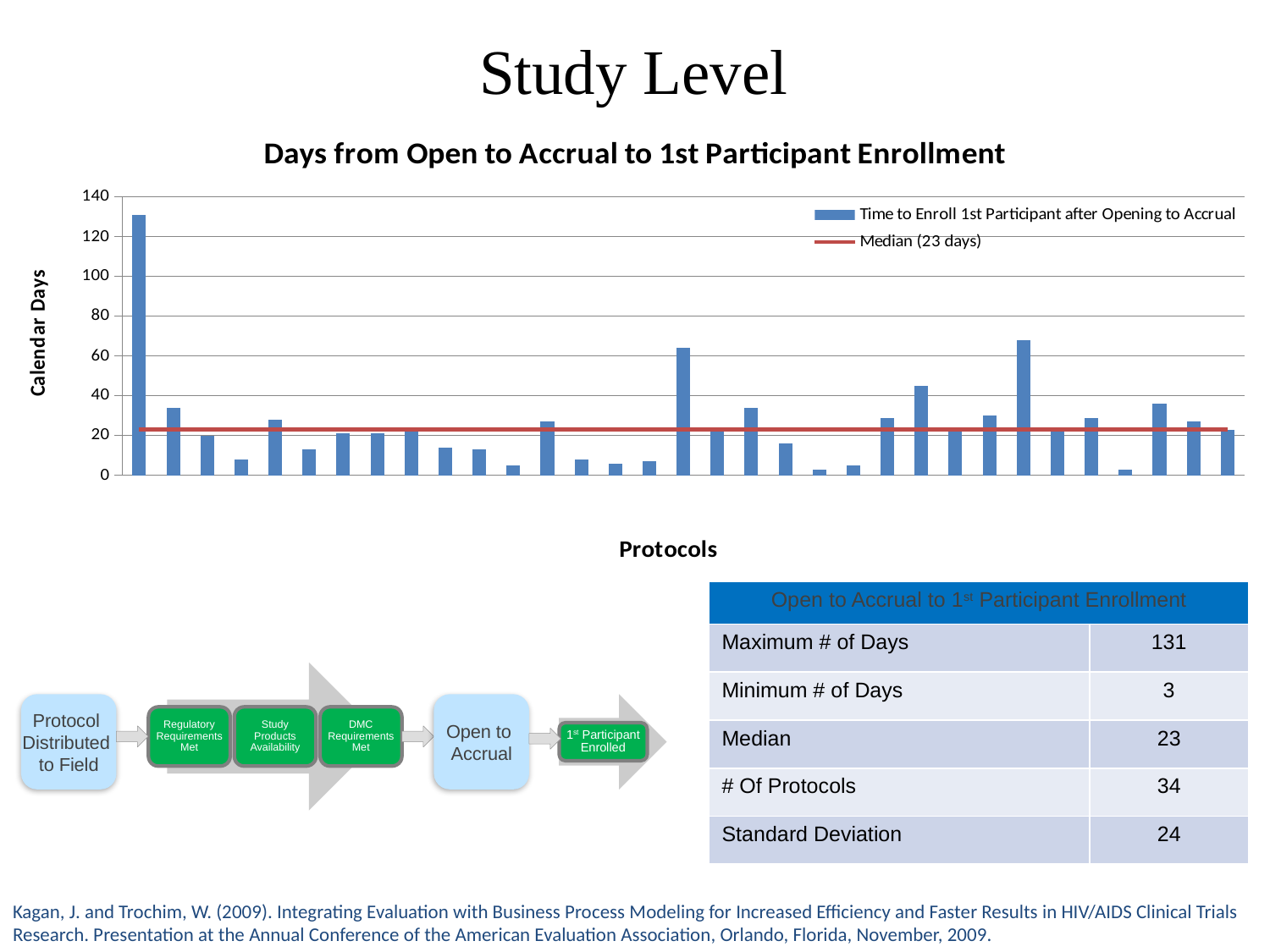
Which bar in the chart is the tallest: the leftmost bar or the rightmost bar? the leftmost bar What is the minimum number of days from open to accrual to 1st participant enrollment shown on the slide? 3 Is the value for the fourth bar from the left greater or less than 20? less What kind of chart is shown on the slide? bar chart What is the maximum number of days from open to accrual to 1st participant enrollment shown on the slide? 131 How many protocols are plotted in the chart? 33 What is the difference between the maximum and minimum number of days reported on the slide? 128 How many entries does the chart's legend list? 2 Is the value for the second bar from the left greater or less than 20? greater What value does the red horizontal line on the chart represent, according to the legend? Median (23 days) What is the title of the chart? Days from Open to Accrual to 1st Participant Enrollment Is the value for the leftmost bar in the chart greater or less than 120? greater